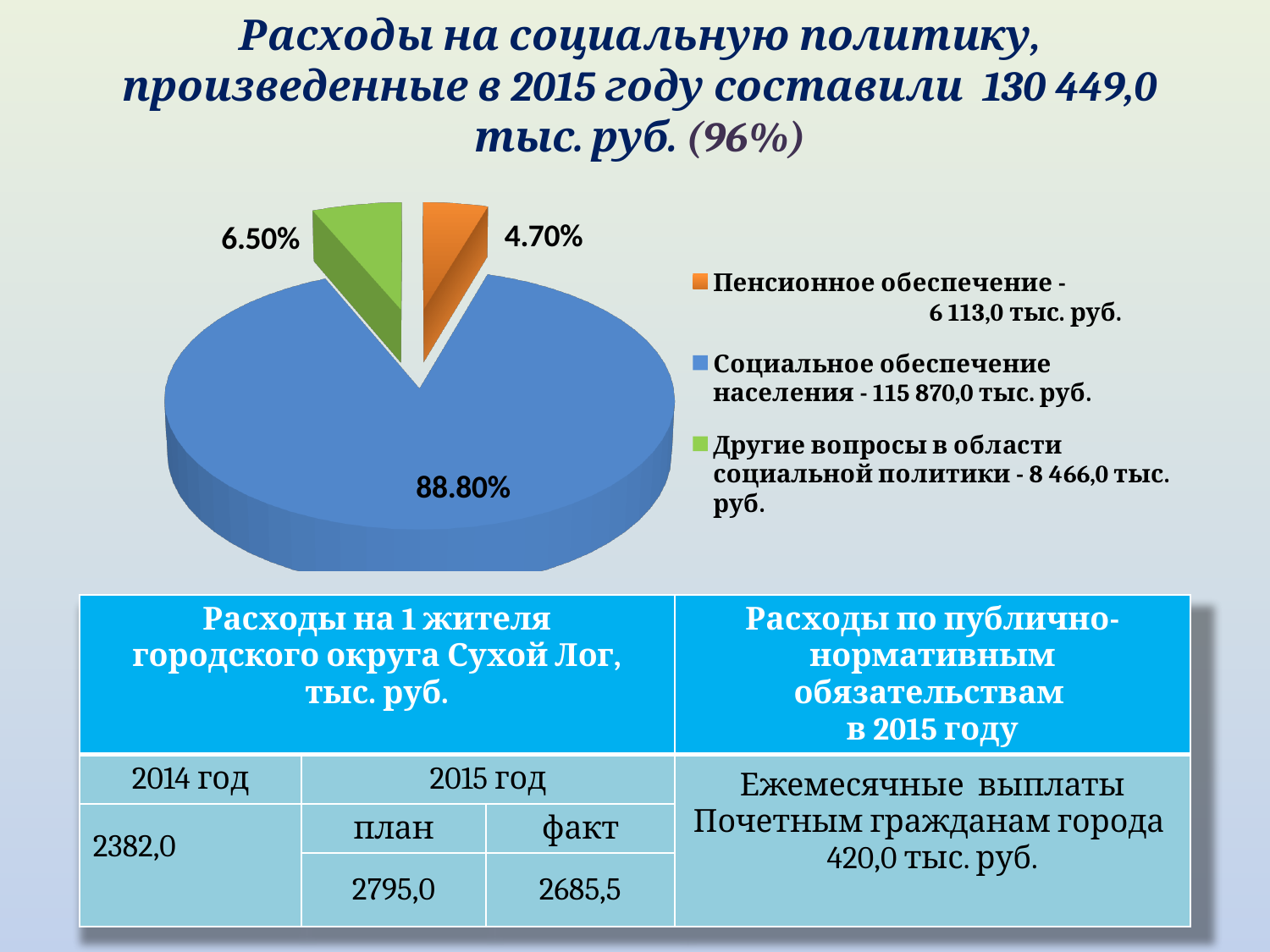
How many slices does the pie chart have? 3 Which category has the smallest slice of the pie? Пенсионное обеспечение What is the difference in percentage points between the "Другие вопросы в области социальной политики" slice and the "Пенсионное обеспечение" slice? 1.80% What share of the pie does "Пенсионное обеспечение" take? 4.70% What kind of chart is shown on the slide? pie chart What colour is the slice for "Социальное обеспечение населения"? blue What share of the pie does "Социальное обеспечение населения" take? 88.80% Which slice is larger: "Другие вопросы в области социальной политики" or "Пенсионное обеспечение"? Другие вопросы в области социальной политики How many entries does the legend of the pie chart list? 3 According to the legend, what amount in тыс. руб. corresponds to "Пенсионное обеспечение"? 6 113,0 тыс. руб. What share of the pie does "Другие вопросы в области социальной политики" take? 6.50% Which category has the largest slice of the pie? Социальное обеспечение населения